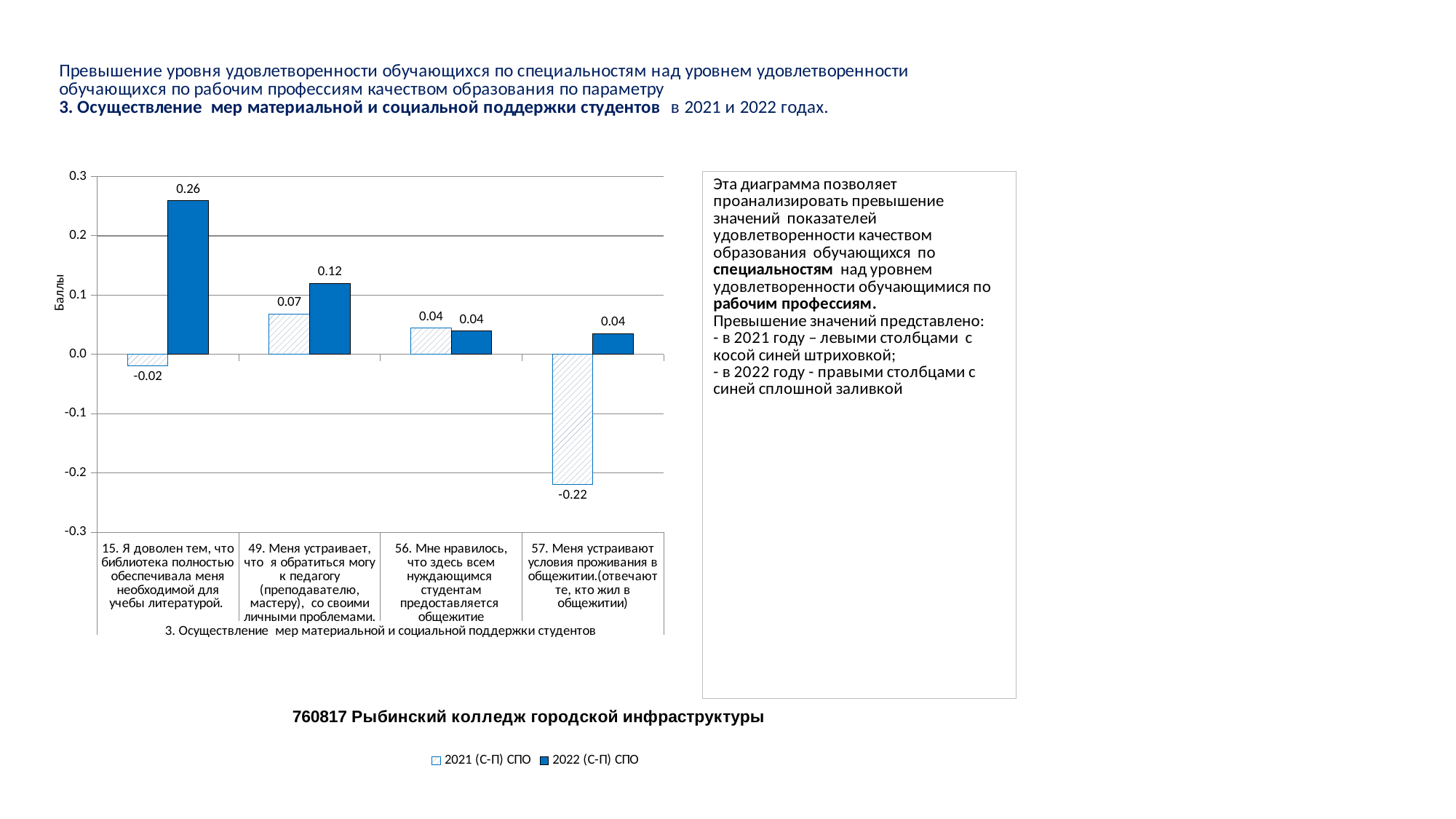
What is the value for 2021 (С-П) СПО for category 49 (can approach a teacher with personal problems)? 0.07 What is the value for 2021 (С-П) СПО for category 57 (dormitory living conditions)? -0.22 What is the difference between the 2022 and 2021 values for category 57 (dormitory living conditions)? 0.26 How many categories are shown on the x axis of the chart? 4 What is the value for 2022 (С-П) СПО for category 15 (library literature)? 0.26 Which category has the lowest value for the 2021 (С-П) СПО series? 57. Меня устраивают условия проживания в общежитии.(отвечают те, кто жил в общежитии) What is the difference between the 2022 and 2021 values for category 15 (library literature)? 0.28 What is the label of the y axis of the chart? Баллы Which is larger for category 49: the 2021 (С-П) СПО value or the 2022 (С-П) СПО value? 2022 (С-П) СПО What type of chart is shown on the slide? bar chart Which category has the highest value for the 2022 (С-П) СПО series? 15. Я доволен тем, что библиотека полностью обеспечивала меня необходимой для учебы литературой. How many series does the chart legend list? 2